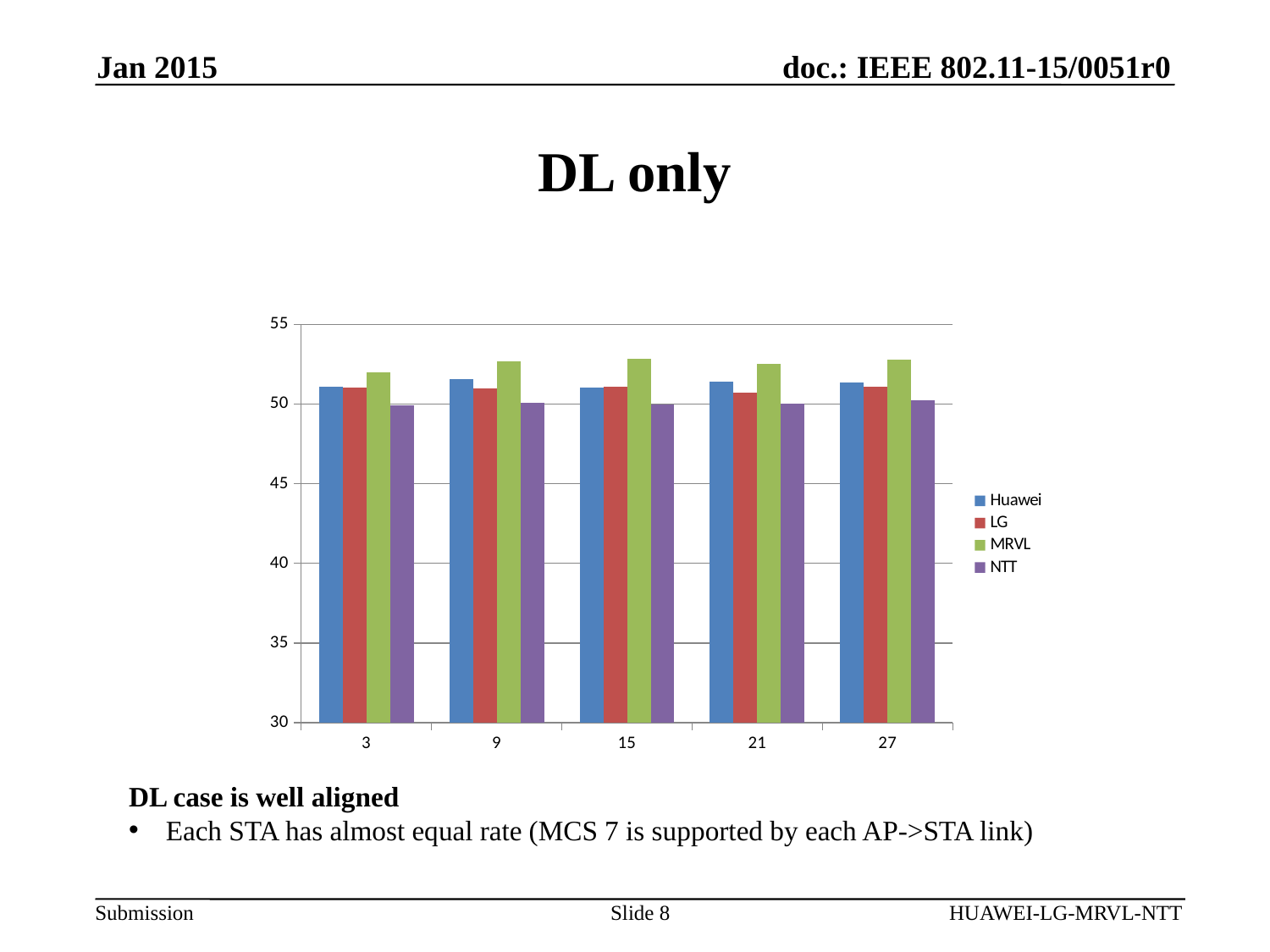
At category 21, which is larger: the MRVL value or the LG value? MRVL At category 27, which is larger: the MRVL value or the NTT value? MRVL What are the series names listed in the legend? Huawei, LG, MRVL, NTT Is the value for NTT at category 15 greater or less than 55? less How many series does the legend list? 4 Is the value for Huawei at category 3 greater or less than 45? greater What kind of chart is shown on the slide? bar chart Which series has the highest value at category 15? MRVL What is the title of the slide containing the chart? DL only Is the value for MRVL at category 9 greater or less than 50? greater How many categories are shown on the x axis? 5 Which series has the lowest value at category 3? NTT